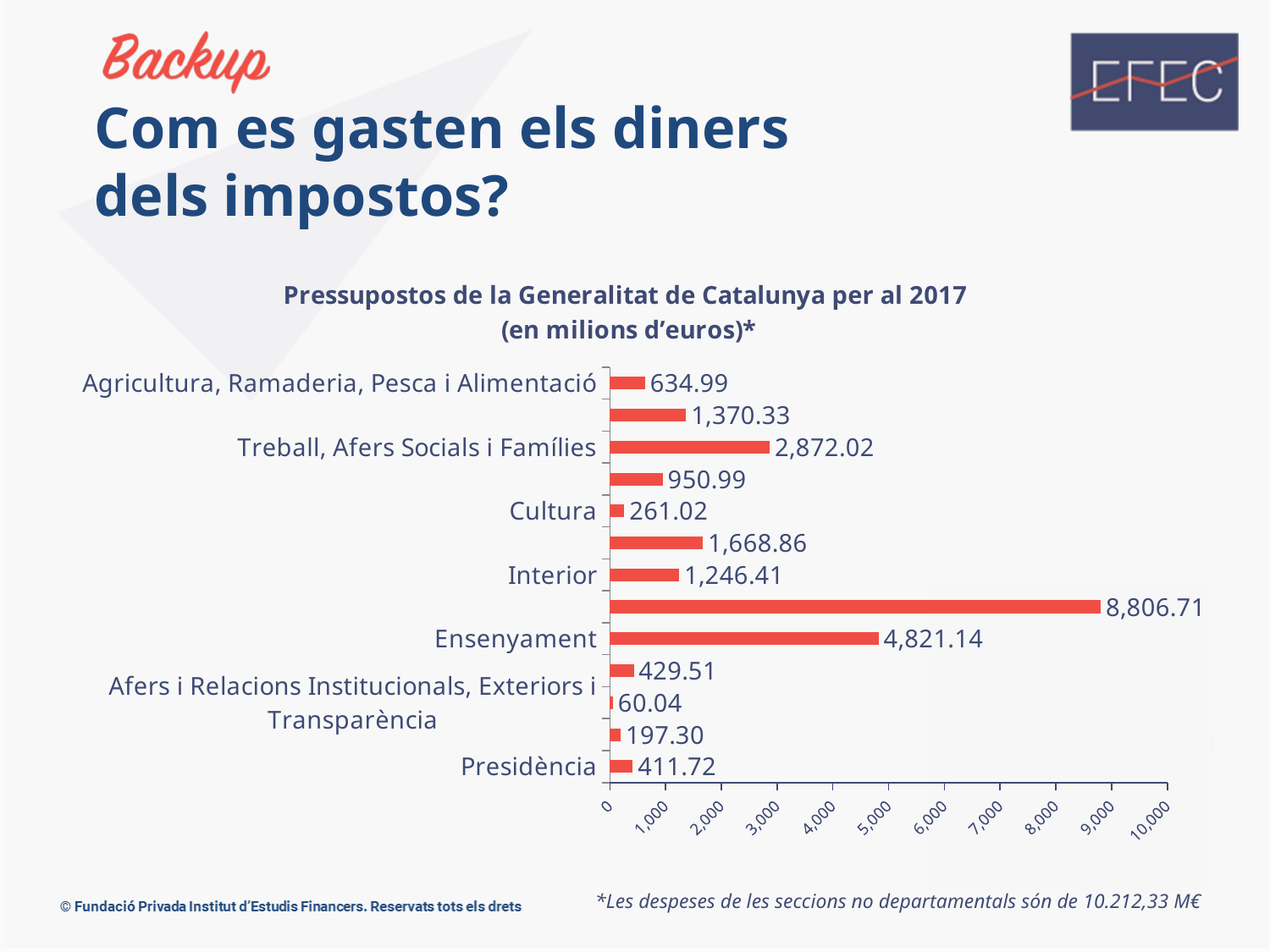
What is the difference between the values for Ensenyament and Interior? 3,574.73 What is the value for Cultura? 261.02 How many bars are plotted on the chart? 13 What is the value for Presidència? 411.72 Is the value for Ensenyament greater or less than 4,000? greater What kind of chart is shown on the slide? Bar chart What is the value for Treball, Afers Socials i Famílies? 2,872.02 What is the smallest value shown on the chart? 60.04 What is the value for Ensenyament? 4,821.14 Which is larger, the value for Cultura or the value for Presidència? Presidència What is the largest value shown on the chart? 8,806.71 What is the value for Agricultura, Ramaderia, Pesca i Alimentació? 634.99